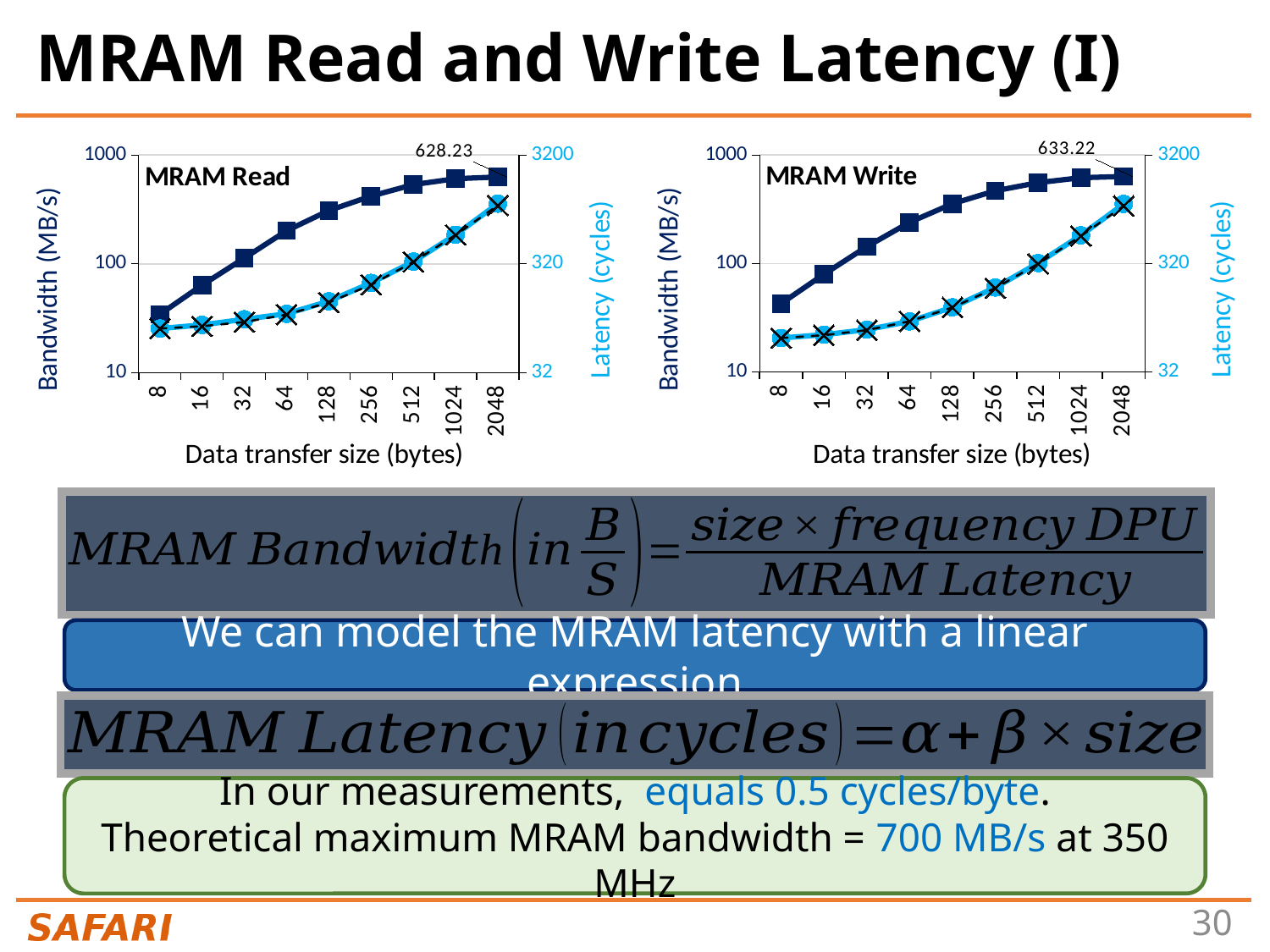
In the MRAM Write chart, what is the bandwidth value labeled at a data transfer size of 2048 bytes? 633.22 What is the difference between the labeled 2048-byte bandwidth in the MRAM Write chart and in the MRAM Read chart? 4.99 What kind of chart is the MRAM Read chart? Line chart In the MRAM Read chart, at which data transfer size is bandwidth highest? 2048 In the MRAM Read chart, what is the bandwidth value labeled at a data transfer size of 2048 bytes? 628.23 What is the x-axis title of the MRAM Read chart? Data transfer size (bytes) Comparing the labeled bandwidth at 2048 bytes, which chart shows the larger value, MRAM Read or MRAM Write? MRAM Write In the MRAM Write chart, is the latency at 2048 bytes greater or less than 320 cycles? greater How many data transfer sizes are plotted along the x axis of the MRAM Read chart? 9 In the MRAM Write chart, does bandwidth rise or fall as the data transfer size increases? Rises In the MRAM Write chart, at which data transfer size is bandwidth lowest? 8 In the MRAM Read chart, is the bandwidth at 8 bytes greater or less than 100 MB/s? less